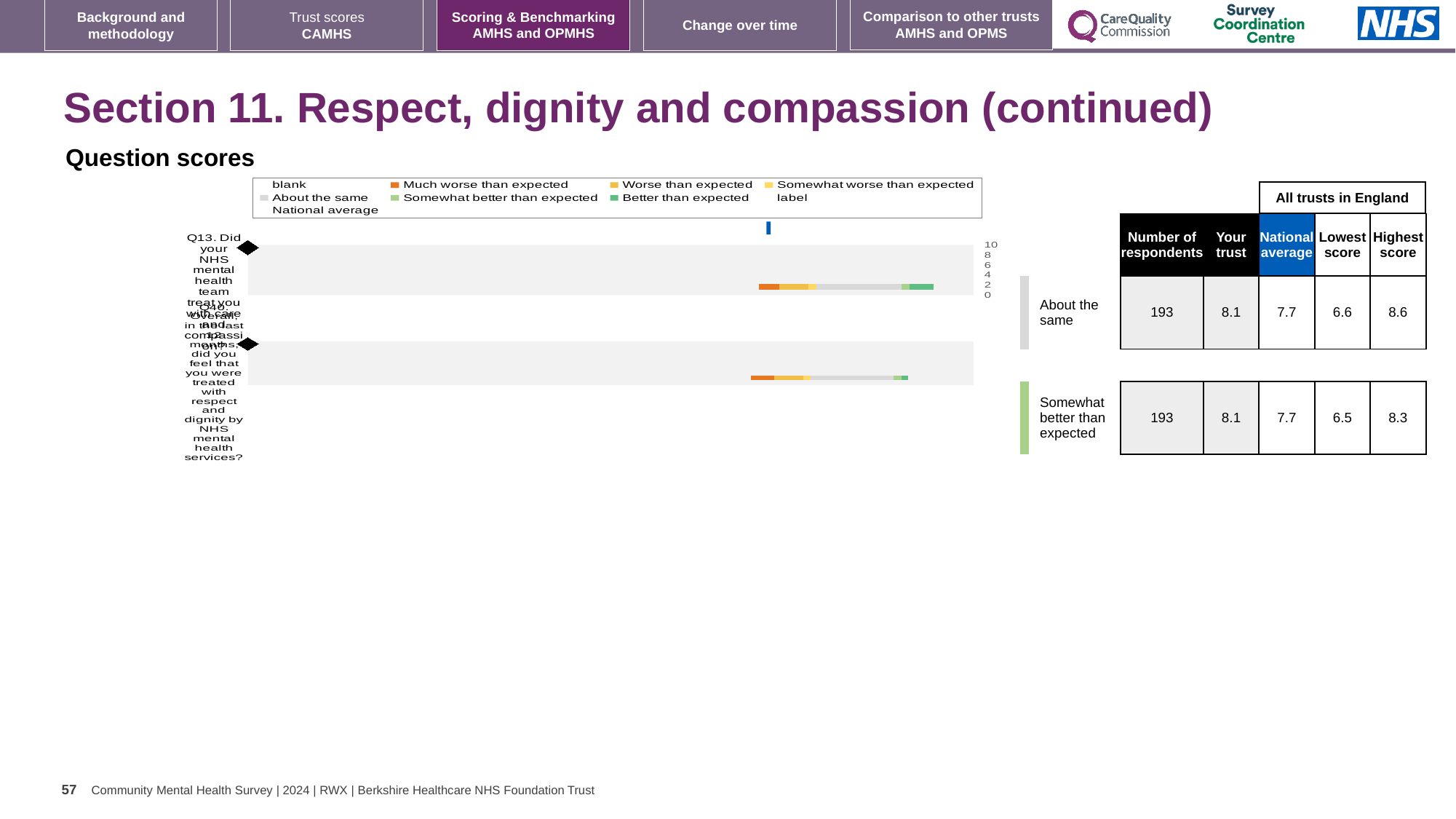
In the table beside the chart, what is the 'Your trust' score for Q13? 8.1 In the table beside the chart, how many respondents answered Q10? 193 In the table beside the chart, what is the highest score for Q10? 8.3 How many entries does the legend of the question scores chart list? 9 How many survey questions are plotted in the question scores chart? 2 Which benchmark category is shown for Q13 in the table beside the chart? About the same What type of chart is used to show the question scores? bar chart In the legend of the question scores chart, what colour represents 'Much worse than expected'? orange In the table beside the chart, which is larger for Q13: the 'Your trust' score or the national average? Your trust In the table beside the chart, what is the difference between the lowest score for Q13 and the lowest score for Q10? 0.1 In the table beside the chart, what is the difference between the highest score and the lowest score for Q13? 2.0 Which benchmark category is shown for Q10 in the table beside the chart? Somewhat better than expected